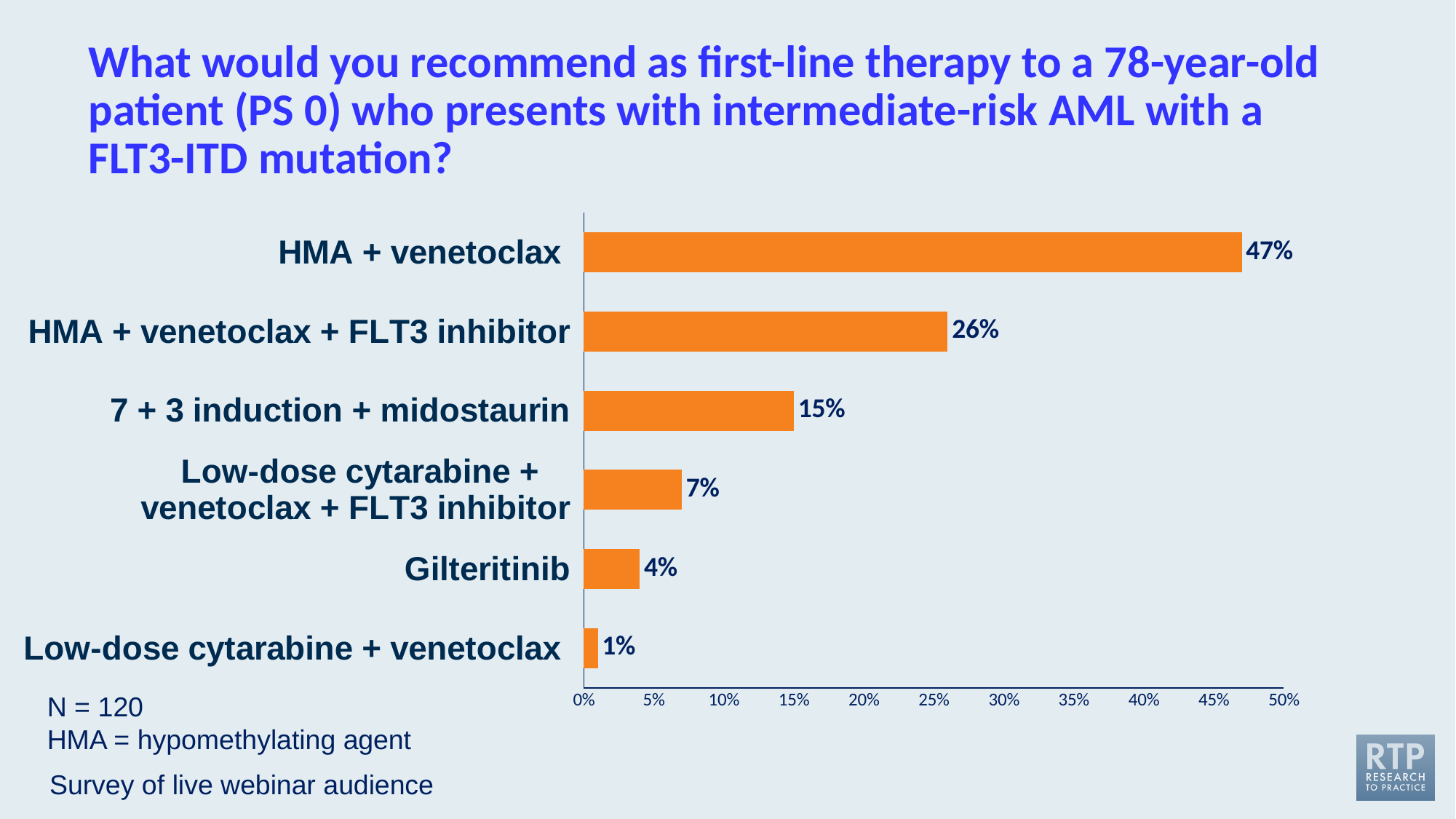
What percentage of respondents recommended HMA + venetoclax + FLT3 inhibitor? 26% What percentage of respondents recommended 7 + 3 induction + midostaurin? 15% How many treatment options are shown in the chart? 6 What percentage of respondents recommended HMA + venetoclax? 47% Which received a higher percentage: Low-dose cytarabine + venetoclax + FLT3 inhibitor or Gilteritinib? Low-dose cytarabine + venetoclax + FLT3 inhibitor What is the difference in percentage points between HMA + venetoclax and HMA + venetoclax + FLT3 inhibitor? 21 percentage points What percentage of respondents recommended Gilteritinib? 4% What is the number of survey respondents (N) stated on the slide? 120 Which option received the lowest percentage of responses? Low-dose cytarabine + venetoclax Which option received the highest percentage of responses? HMA + venetoclax What kind of chart is shown on the slide? Bar chart Is the value for 7 + 3 induction + midostaurin greater or less than 20%? less